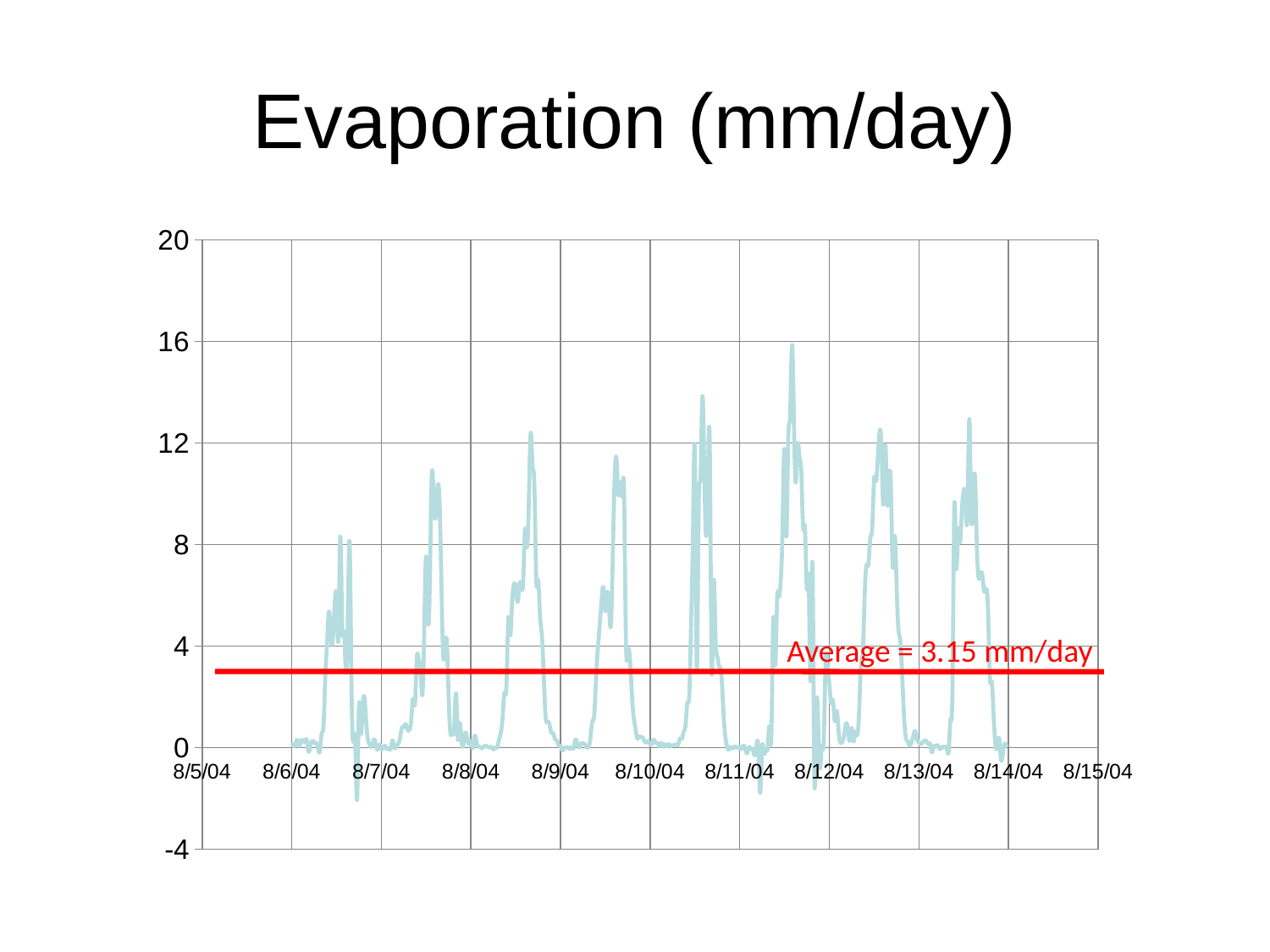
What average value is annotated on the chart? 3.15 mm/day Is the average line drawn above or below the 4 gridline? below What kind of chart is shown on the slide? line chart Is the highest peak near 8/11/04 greater or less than 12? greater What is the last date label on the x axis? 8/15/04 What is the lowest value shown on the y axis? -4 Is the peak near 8/6/04 greater or less than 12? less What is the first date label on the x axis? 8/5/04 What is the highest value shown on the y axis? 20 Around which date does the evaporation reach its highest peak? 8/11/04 What is the title of the chart? Evaporation (mm/day) How many date labels are shown on the x axis? 11